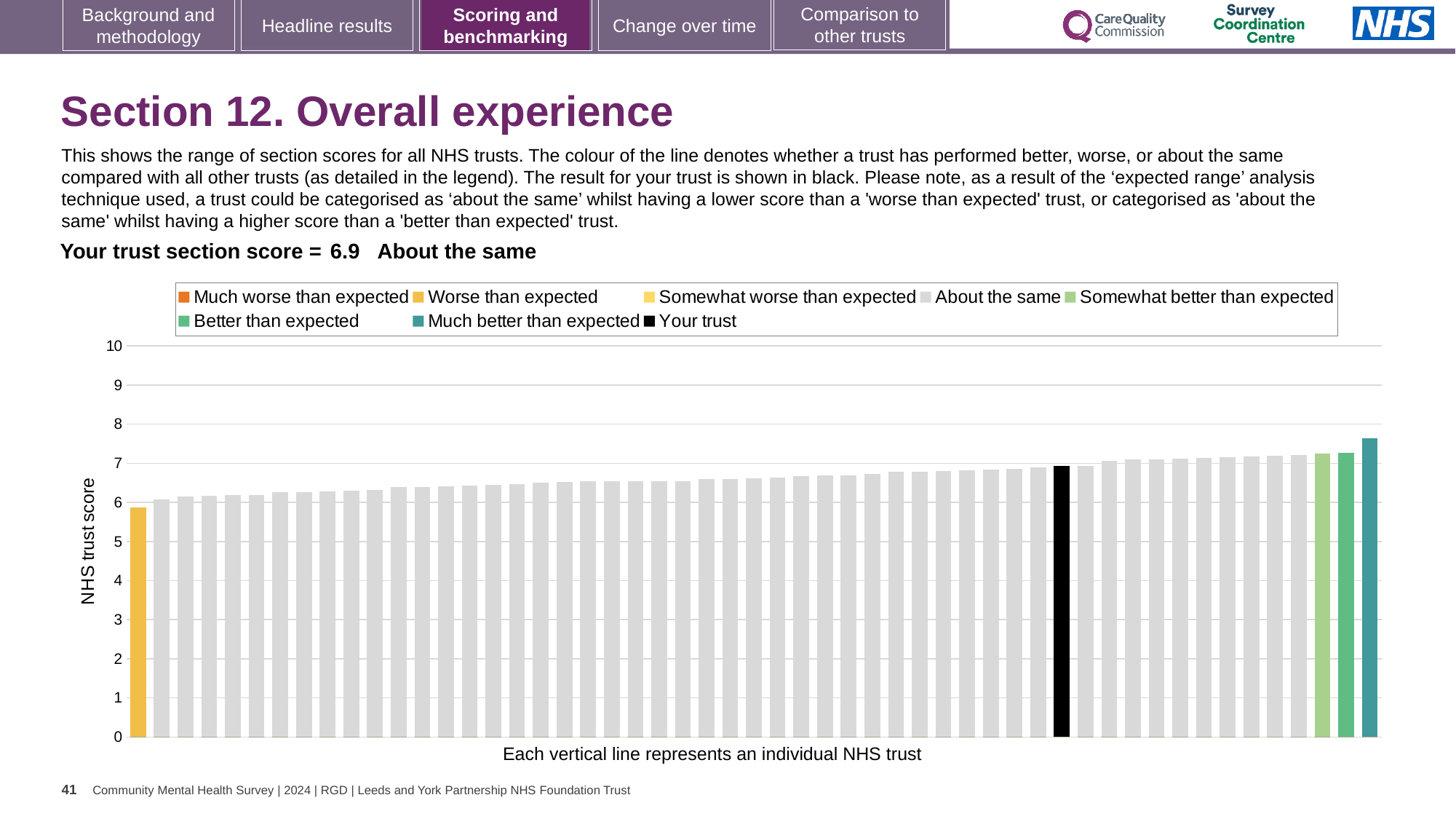
Is the value for the yellow 'Worse than expected' bar greater or less than 6? less How many entries does the chart legend list? 8 Do the bar values rise or fall from left to right along the x axis? Rise What kind of chart is shown on the slide? Bar chart How is your trust's section score categorised compared with other trusts? About the same What is the section score for your trust shown on the slide? 6.9 Is the value for the 'Much better than expected' bar greater or less than 7? greater What is the label on the vertical axis of the chart? NHS trust score Which legend category does the lowest bar in the chart belong to? Worse than expected Is the value for the black 'Your trust' bar greater or less than 6? greater What colour is used for the 'Your trust' bar in the chart? Black Which legend category does the highest bar in the chart belong to? Much better than expected